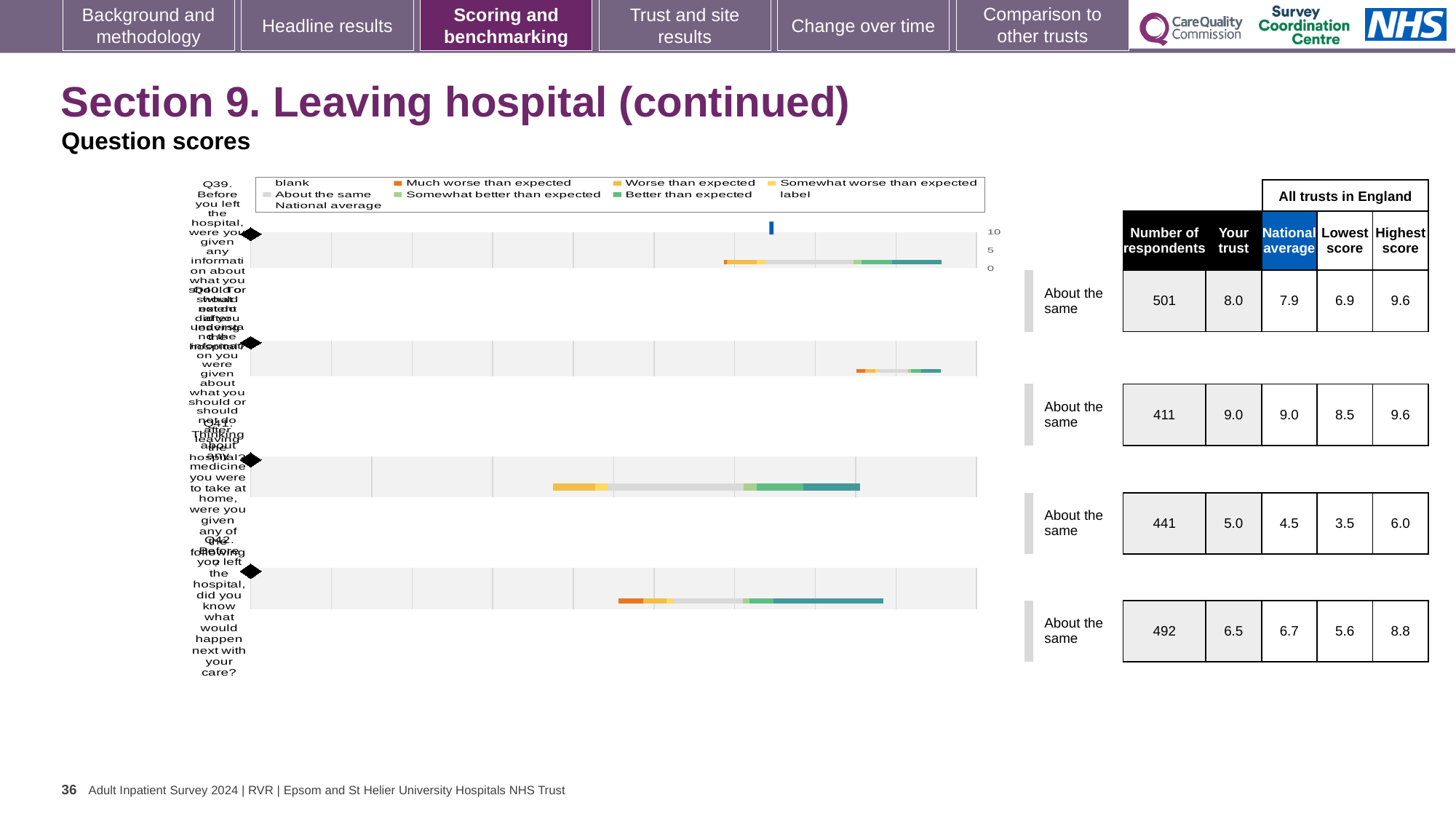
In the table next to the chart, what is the number of respondents in the first row? 501 In the first row of the table next to the chart, which is larger: the 'Your trust' score or the national average? Your trust In the table next to the chart, what is the 'Your trust' score in the second row? 9.0 What benchmark category is shown beside each of the four bars in the chart? About the same In the table next to the chart, which row has the highest 'Your trust' score? the second row (9.0) In the table next to the chart, what is the difference between the highest score and the lowest score in the first row? 2.7 In the table next to the chart, what is the highest score in the third row? 6.0 In the table next to the chart, which row has the lowest 'Your trust' score? the third row (5.0) In the table next to the chart, what is the lowest score in the fourth row? 5.6 In the chart legend, what colour represents 'Much worse than expected'? orange What kind of chart is shown on the slide? bar chart How many survey questions (bars) are plotted in the chart? 4